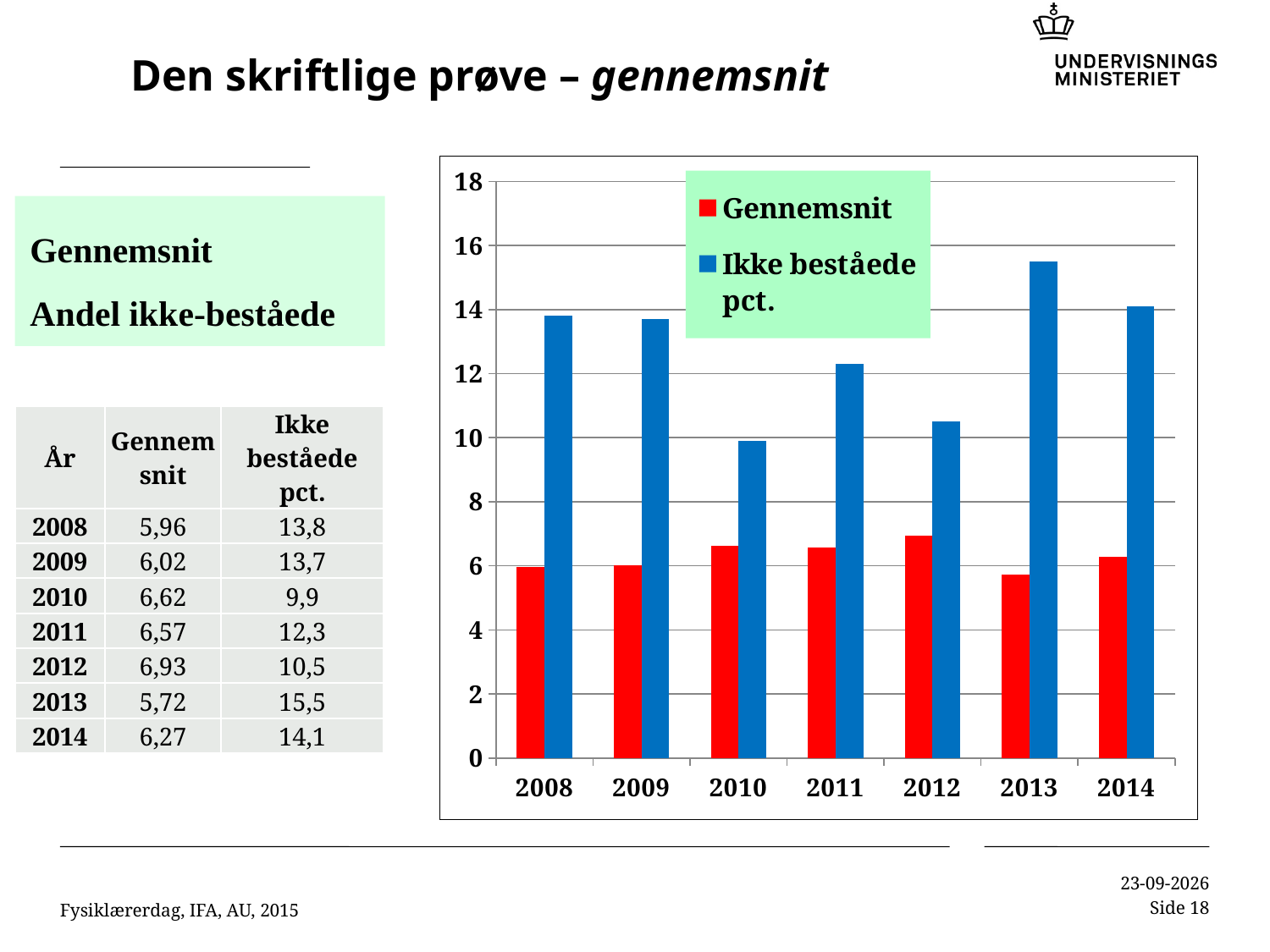
What is the Ikke beståede pct. value for 2013? 15,5 Is the Ikke beståede pct. value for 2011 greater or less than 12? greater What is the difference between the Ikke beståede pct. values for 2013 and 2010? 5,6 How many series does the chart legend list? 2 Which year has the lowest Ikke beståede pct. value? 2010 Which year has the highest Ikke beståede pct. value? 2013 Which is larger, the Ikke beståede pct. value for 2008 or for 2012? 2008 How many years are shown on the x axis of the chart? 7 Which year has the lowest Gennemsnit value? 2013 Which colour represents the Gennemsnit series in the chart? red What kind of chart is shown on the slide? bar chart What is the Gennemsnit value for 2012? 6,93